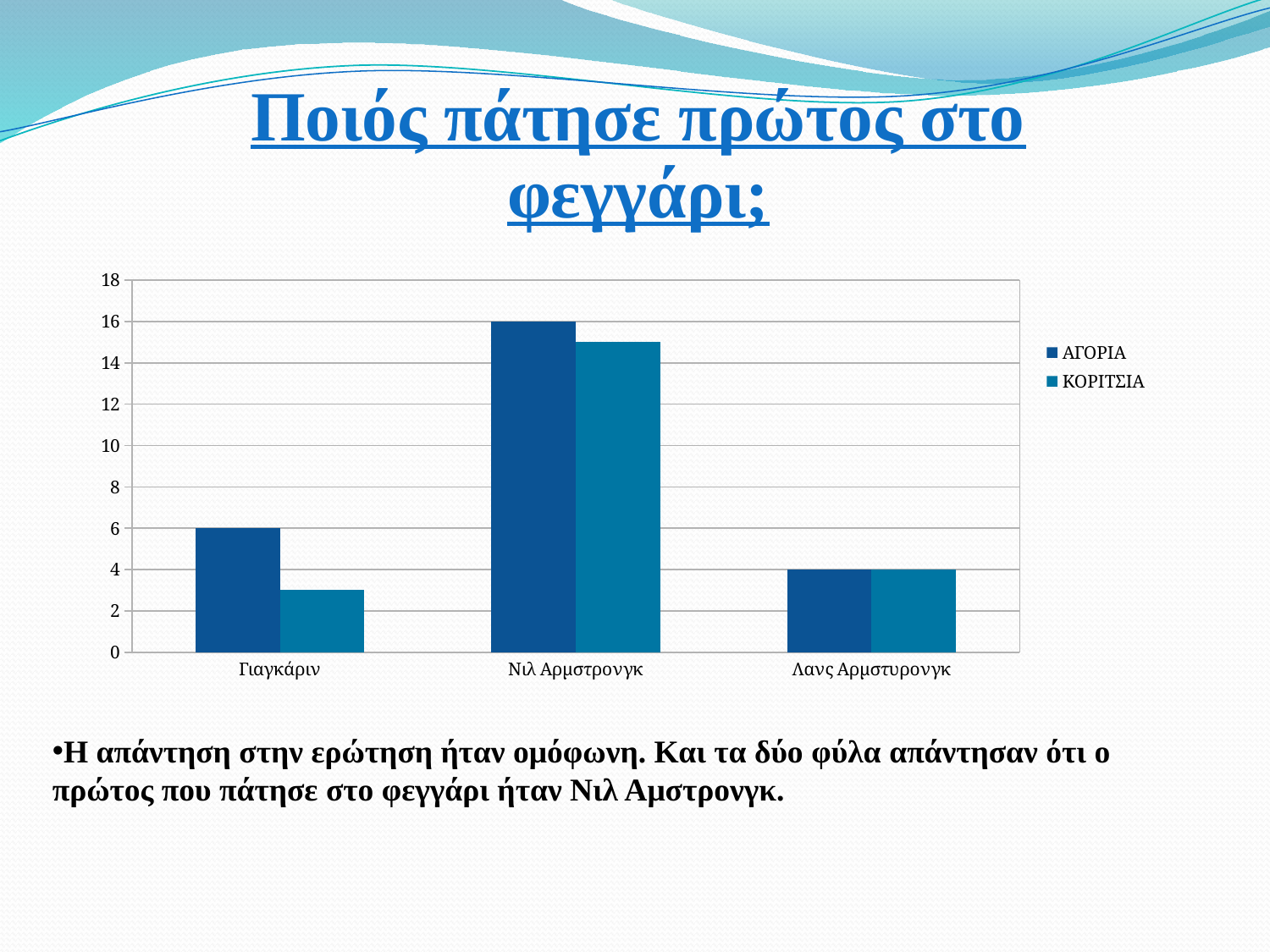
What is the difference between the ΑΓΟΡΙΑ values for Νιλ Αρμστρονγκ and Γιαγκάριν? 10 Which category has the highest value for ΚΟΡΙΤΣΙΑ? Νιλ Αρμστρονγκ Which category has the lowest value for ΑΓΟΡΙΑ? Λανς Αρμστυρονγκ How many series does the chart's legend list? 2 What is the value for ΚΟΡΙΤΣΙΑ in the Λανς Αρμστυρονγκ category? 4 How many categories are shown on the x axis of the chart? 3 In the Γιαγκάριν category, which series has the larger value, ΑΓΟΡΙΑ or ΚΟΡΙΤΣΙΑ? ΑΓΟΡΙΑ What is the value for ΑΓΟΡΙΑ in the Νιλ Αρμστρονγκ category? 16 What kind of chart is shown on the slide? Bar chart What is the value for ΑΓΟΡΙΑ in the Γιαγκάριν category? 6 Is the value for ΚΟΡΙΤΣΙΑ in the Γιαγκάριν category greater or less than 4? less Is the value for ΚΟΡΙΤΣΙΑ in the Νιλ Αρμστρονγκ category greater or less than 14? greater